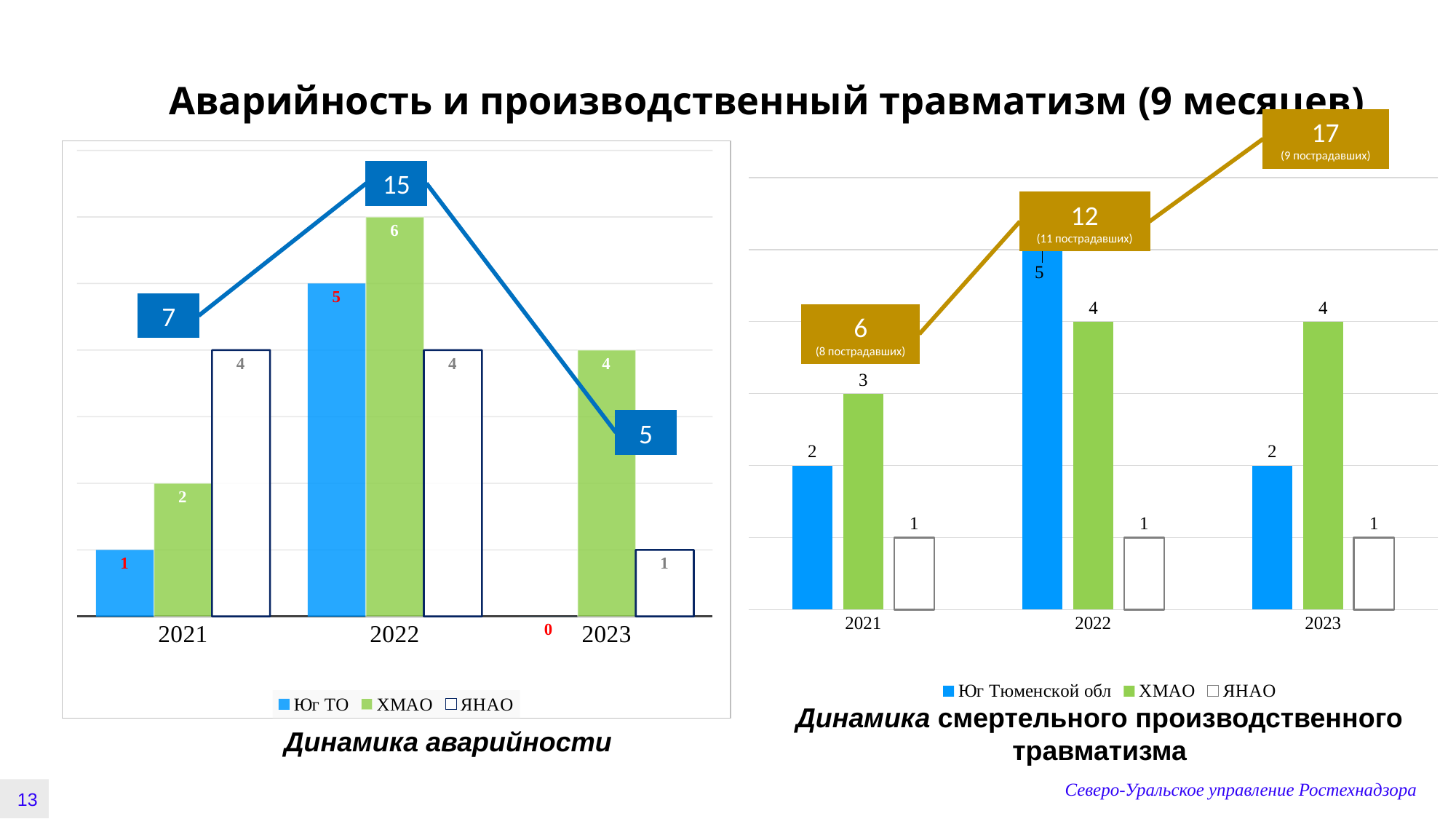
In the chart 'Динамика смертельного производственного травматизма', how many пострадавших are noted for 2022? 11 In the chart 'Динамика аварийности', what is the value for ХМАО in 2022? 6 In the chart 'Динамика аварийности', what is the value for Юг ТО in 2023? 0 In the chart 'Динамика аварийности', how many series does the legend list? 3 In the chart 'Динамика смертельного производственного травматизма', what is the value for Юг Тюменской обл in 2022? 5 In the chart 'Динамика смертельного производственного травматизма', what value does the line show for 2023? 17 In the chart 'Динамика аварийности', which is larger in 2021: ХМАО or ЯНАО? ЯНАО In the chart 'Динамика смертельного производственного травматизма', does the line rise or fall from 2021 to 2023? rise In the chart 'Динамика аварийности', in which year does the line reach its highest value? 2022 In the chart 'Динамика аварийности', what is the difference between the line values for 2022 and 2023? 10 In the chart 'Динамика аварийности', what value does the line show for 2022? 15 In the chart 'Динамика смертельного производственного травматизма', how many years are shown on the x axis? 3